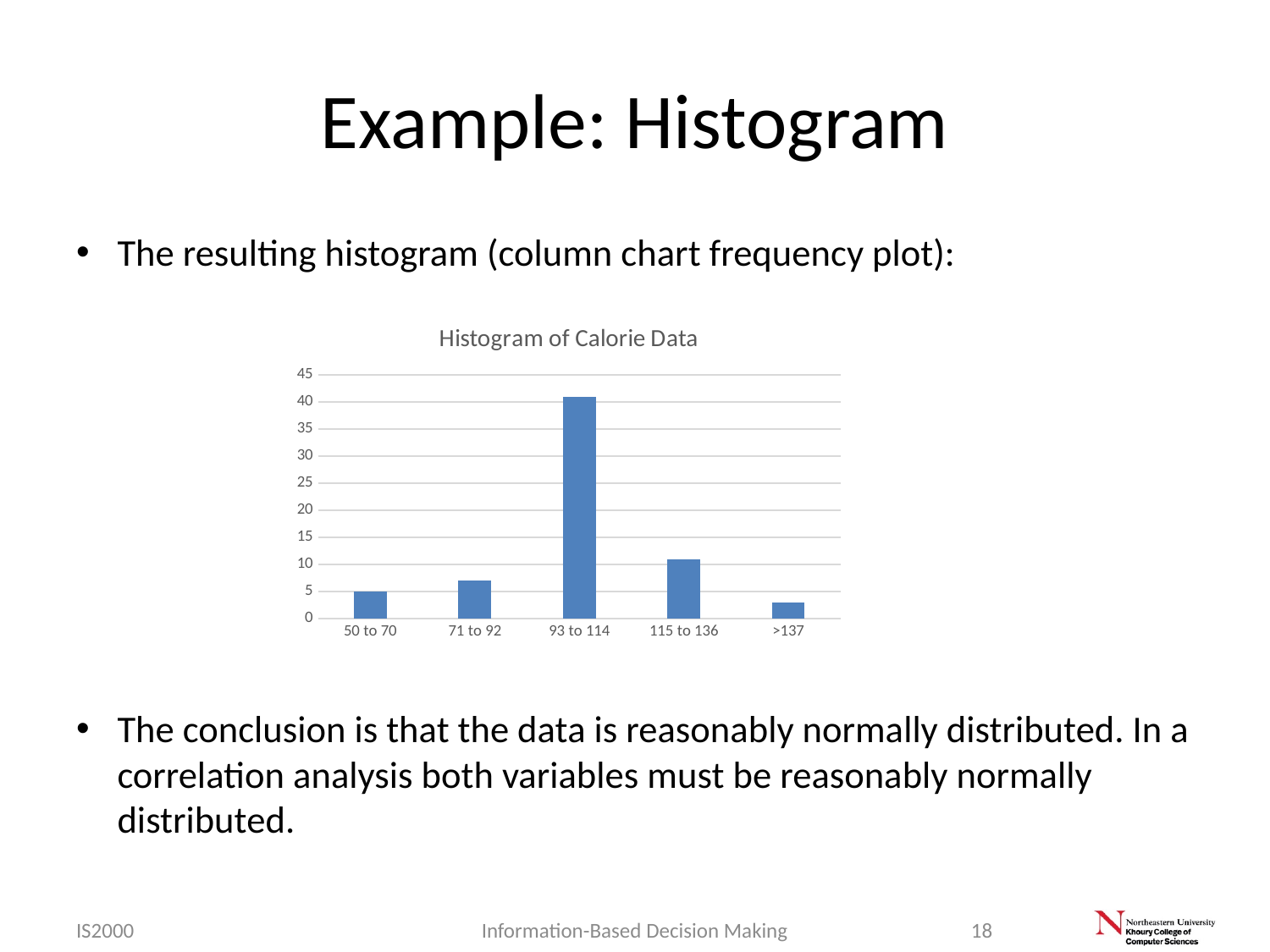
What type of chart is shown on the slide? bar chart What is the maximum value shown on the y axis of the chart? 45 Which is larger, the value for 50 to 70 or the value for >137? 50 to 70 Which category has the lowest bar in the chart? >137 Is the value for 71 to 92 greater or less than 10? less How many categories (bins) are shown on the x axis of the chart? 5 Is the value for >137 greater or less than 5? less Which is larger, the value for 71 to 92 or the value for 115 to 136? 115 to 136 What is the title of the chart? Histogram of Calorie Data Which category has the highest bar in the chart? 93 to 114